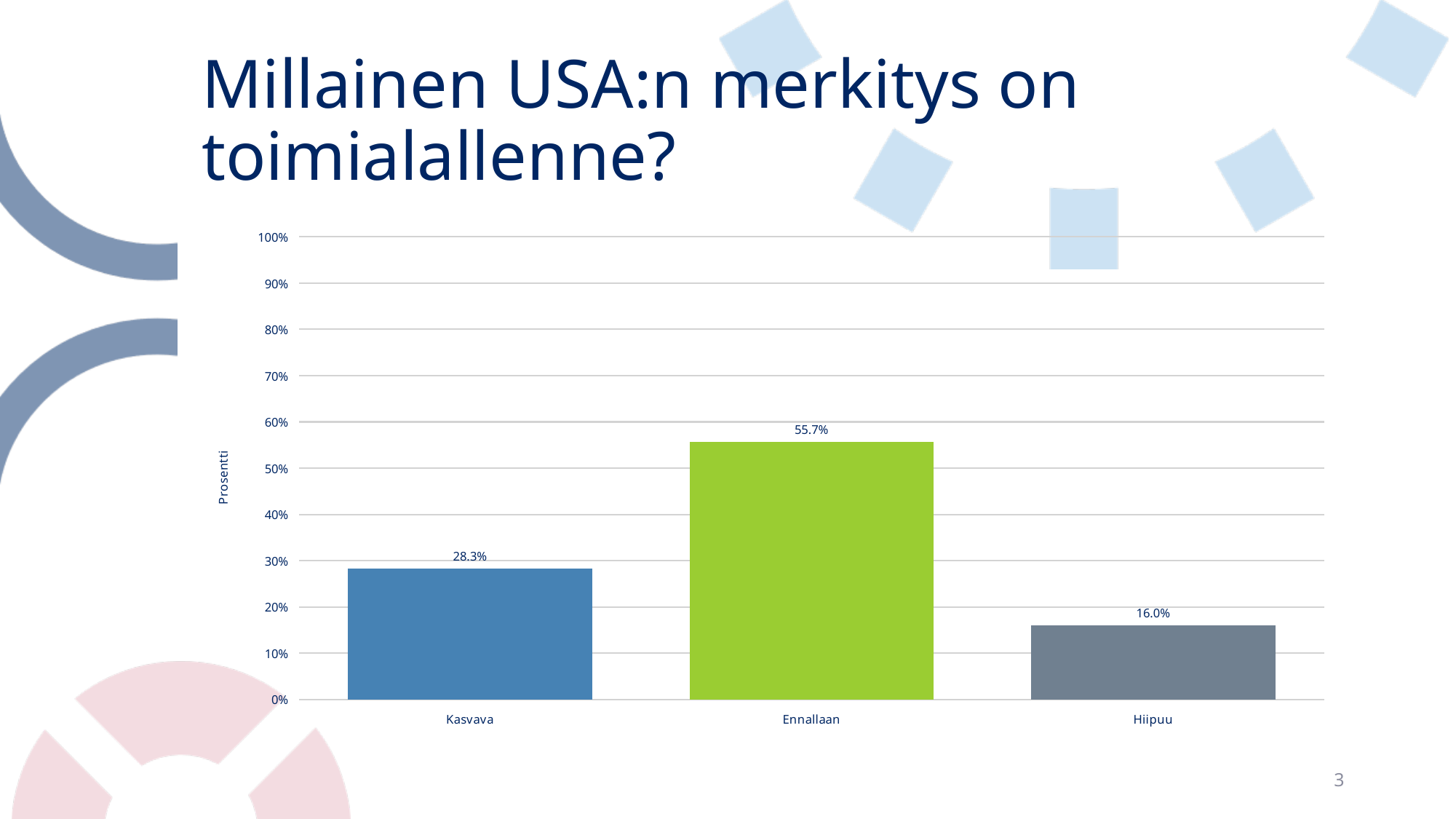
What is the difference between the values for Kasvava and Hiipuu? 12.3% Which category has the lowest value? Hiipuu Is the value for Ennallaan greater or less than 50%? greater What is the difference between the values for Ennallaan and Kasvava? 27.4% What kind of chart is shown on the slide? bar chart What is the value for Kasvava? 28.3% What is the label of the vertical axis? Prosentti What is the value for Hiipuu? 16.0% Which category has the highest value? Ennallaan How many categories are shown on the x axis? 3 Which is larger, the value for Kasvava or the value for Hiipuu? Kasvava What is the value for Ennallaan? 55.7%